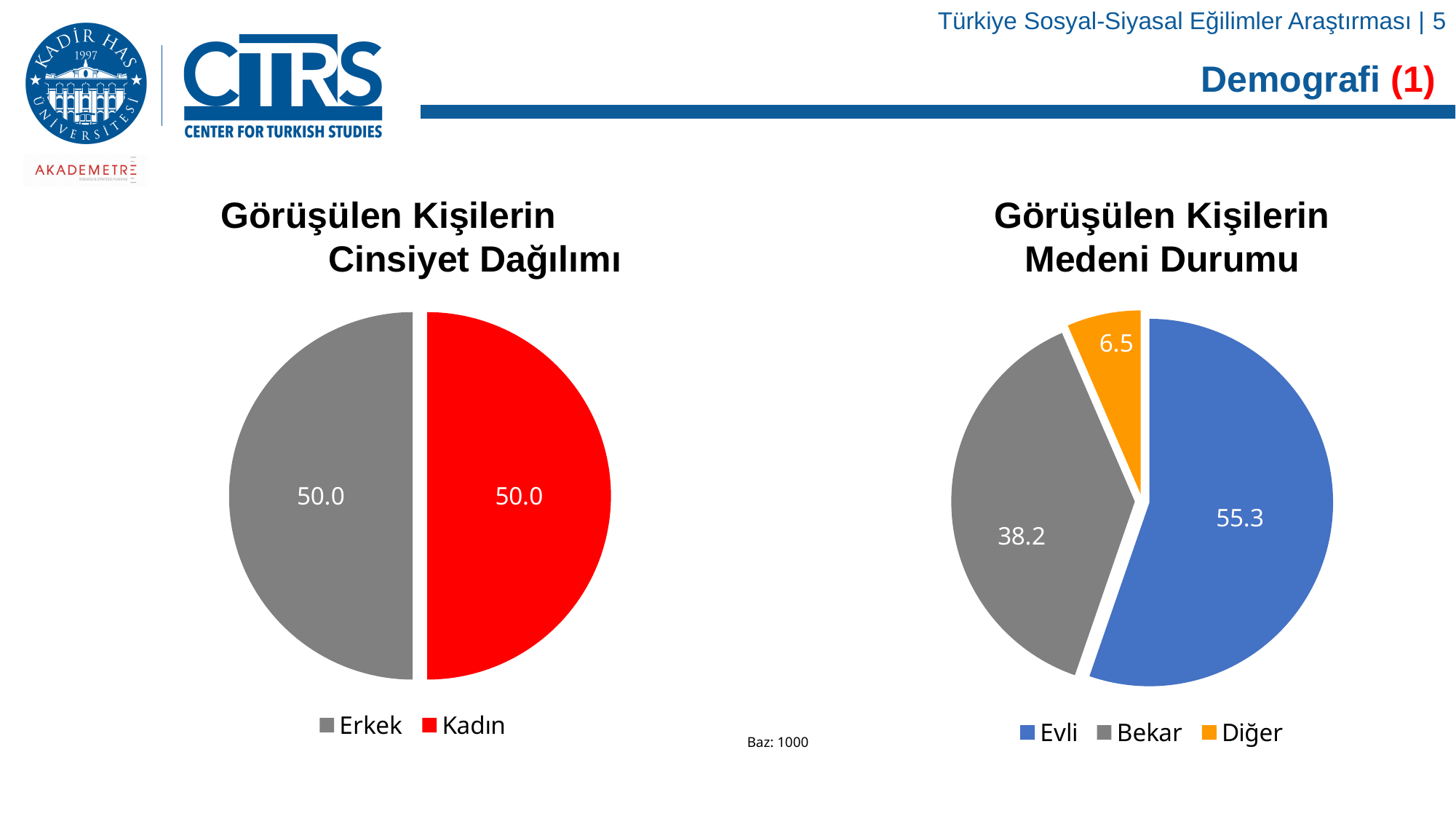
In the 'Görüşülen Kişilerin Medeni Durumu' chart, what is the value for Bekar? 38.2 How many categories does the legend of the 'Görüşülen Kişilerin Medeni Durumu' chart list? 3 In the 'Görüşülen Kişilerin Medeni Durumu' chart, which category has the smallest share? Diğer In the 'Görüşülen Kişilerin Medeni Durumu' chart, what is the difference between the values for Evli and Bekar? 17.1 In the 'Görüşülen Kişilerin Cinsiyet Dağılımı' chart, what is the value for Kadın? 50.0 In the 'Görüşülen Kişilerin Medeni Durumu' chart, which category has the largest share? Evli How many categories does the 'Görüşülen Kişilerin Cinsiyet Dağılımı' chart show? 2 In the 'Görüşülen Kişilerin Medeni Durumu' chart, what is the value for Evli? 55.3 In the 'Görüşülen Kişilerin Medeni Durumu' chart, what colour is the Diğer slice? orange In the 'Görüşülen Kişilerin Medeni Durumu' chart, what is the value for Diğer? 6.5 In the 'Görüşülen Kişilerin Cinsiyet Dağılımı' chart, what is the value for Erkek? 50.0 What kind of chart is the 'Görüşülen Kişilerin Cinsiyet Dağılımı' chart? pie chart